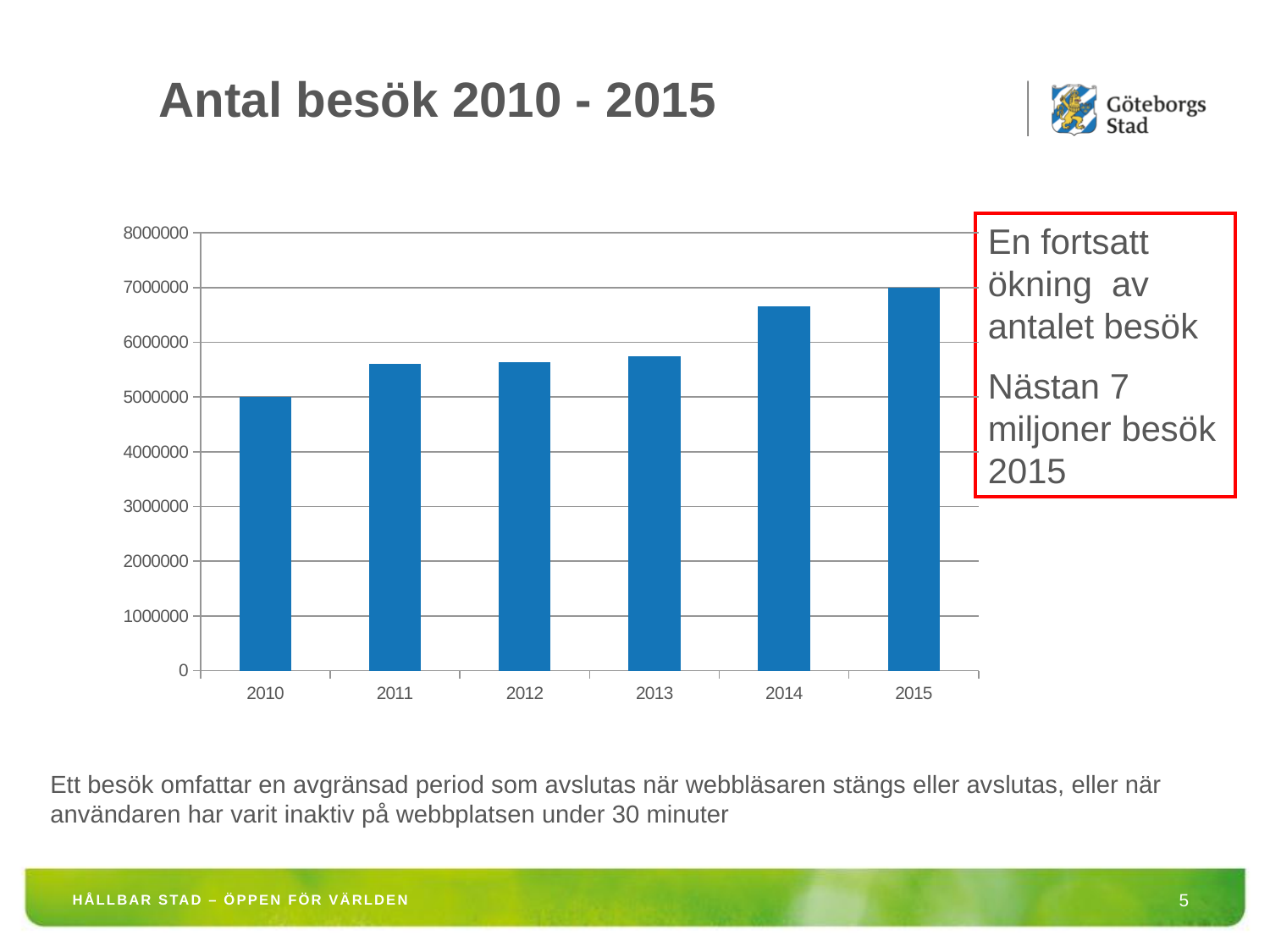
Is the value for 2013 greater or less than 6000000? less Is the value for 2014 greater or less than 6000000? greater Which year has more visits, 2013 or 2014? 2014 Which year has the highest number of visits? 2015 How many years are shown on the x axis of the chart? 6 Which year has more visits, 2010 or 2011? 2011 Is the value for 2015 greater or less than 8000000? less Which year has the lowest number of visits? 2010 What kind of chart is shown on the slide? bar chart Do the values rise or fall from 2010 to 2015? rise What is the title of the chart? Antal besök 2010 - 2015